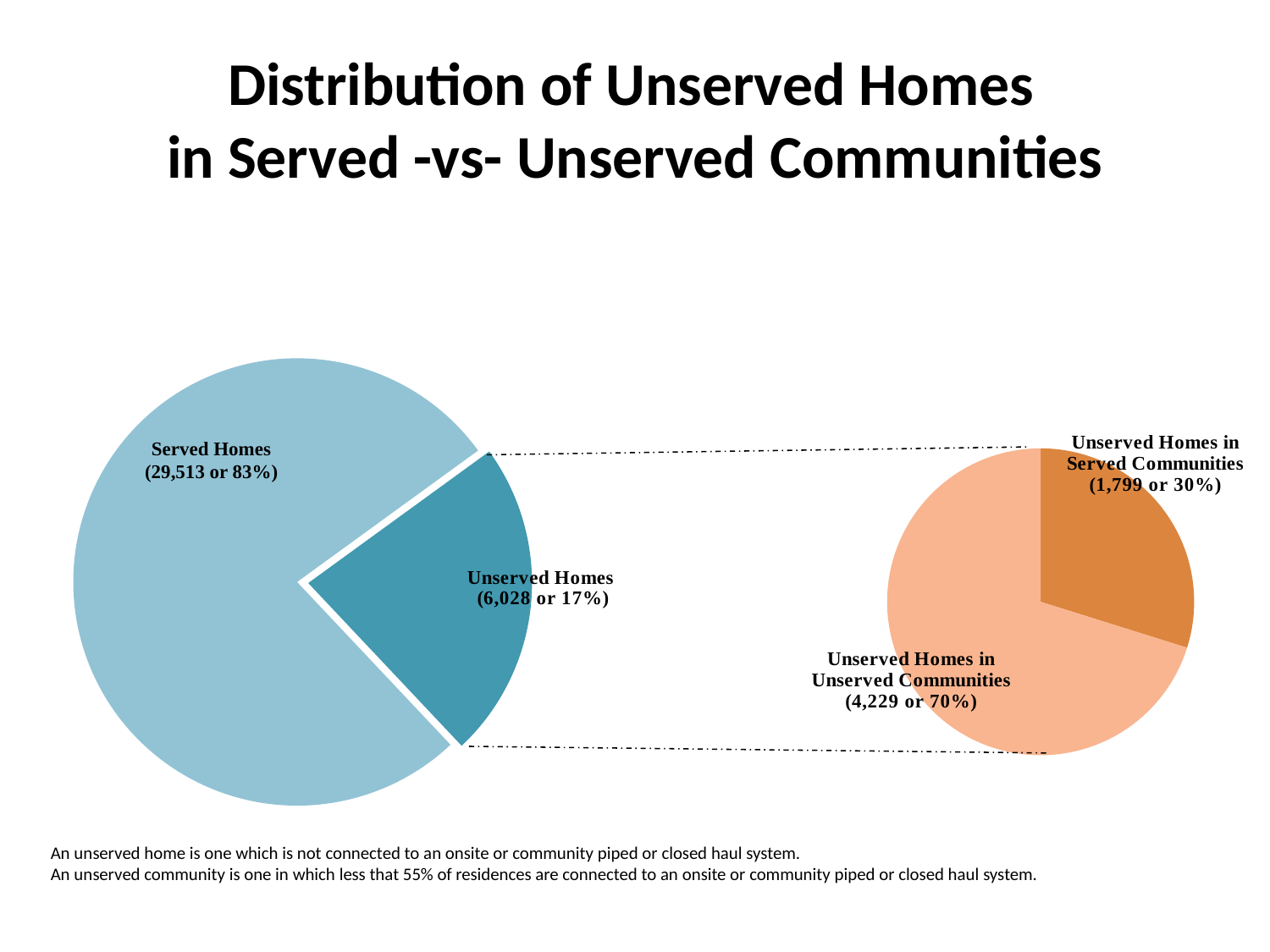
In the left pie chart, what share of the pie is Served Homes? 83% In the left pie chart, how many homes are Served Homes? 29,513 In the right pie chart, which slice is larger: Unserved Homes in Served Communities or Unserved Homes in Unserved Communities? Unserved Homes in Unserved Communities In the right pie chart, how many Unserved Homes are in Unserved Communities? 4,229 What is the title of the slide? Distribution of Unserved Homes in Served -vs- Unserved Communities How many slices does the right pie chart have? 2 In the right pie chart, what is the difference between the number of Unserved Homes in Unserved Communities and in Served Communities? 2,430 In the right pie chart, how many Unserved Homes are in Served Communities? 1,799 What kind of chart is shown on the left of the slide? Pie chart In the left pie chart, how many homes are Unserved Homes? 6,028 In the left pie chart, what share of the pie is Unserved Homes? 17% In the right pie chart, what share of the pie is Unserved Homes in Served Communities? 30%